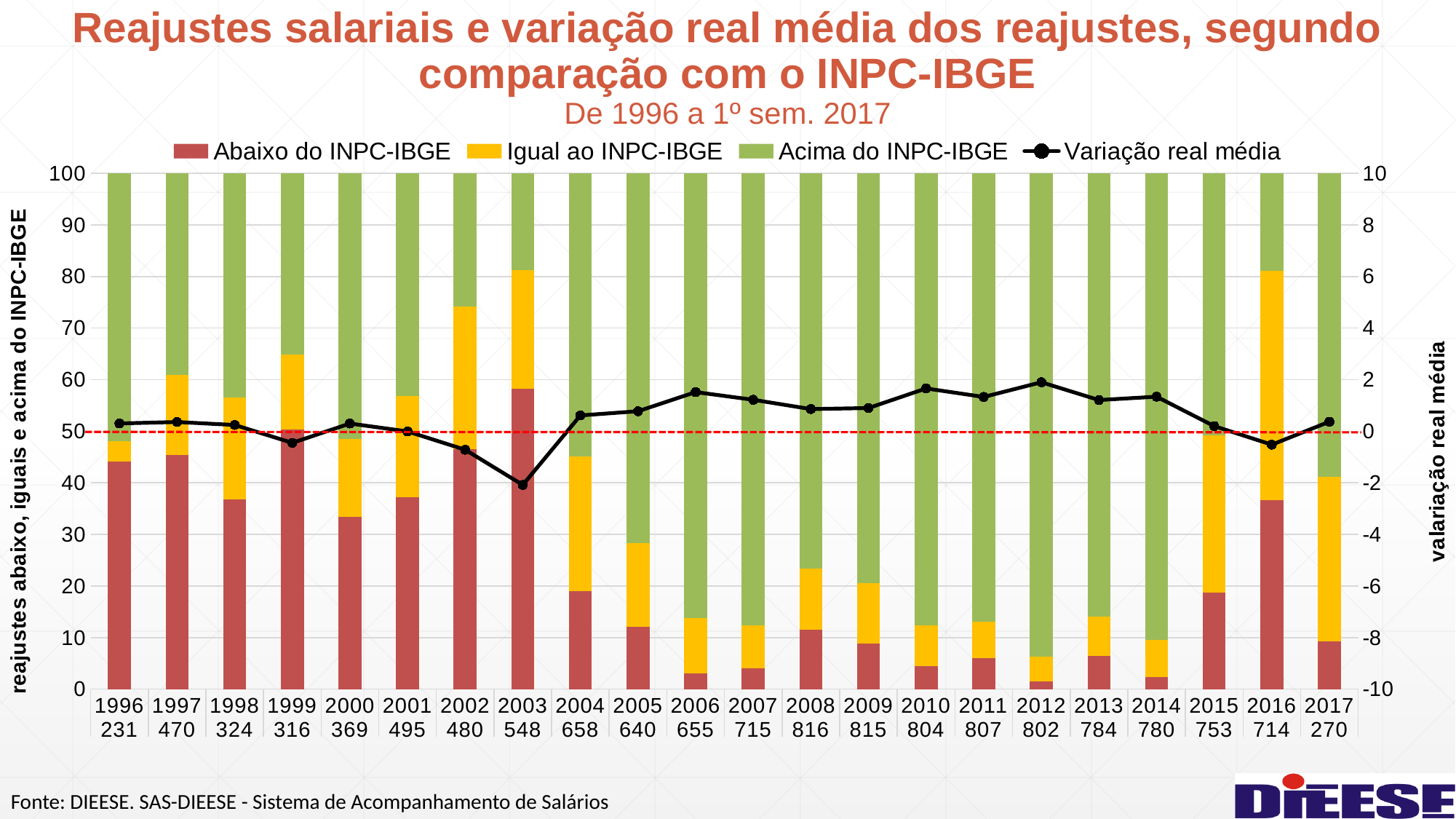
In which year is the 'Variação real média' line at its lowest point? 2003 Is the 'Abaixo do INPC-IBGE' share for 2012 greater or less than 10? less How many years (categories) are shown along the x axis? 22 How many series does the legend list? 4 Is the 'Variação real média' value for 2003 greater or less than 0? less Which year has the largest share of 'Abaixo do INPC-IBGE'? 2003 Which year has the larger 'Abaixo do INPC-IBGE' share, 2003 or 2004? 2003 What kind of chart is shown on the slide? Stacked bar chart with a line What is the period covered by the chart, as stated in the subtitle? De 1996 a 1º sem. 2017 Is the 'Variação real média' value for 2006 greater or less than 0? greater Does the 'Variação real média' line rise or fall from 2003 to 2006? rise